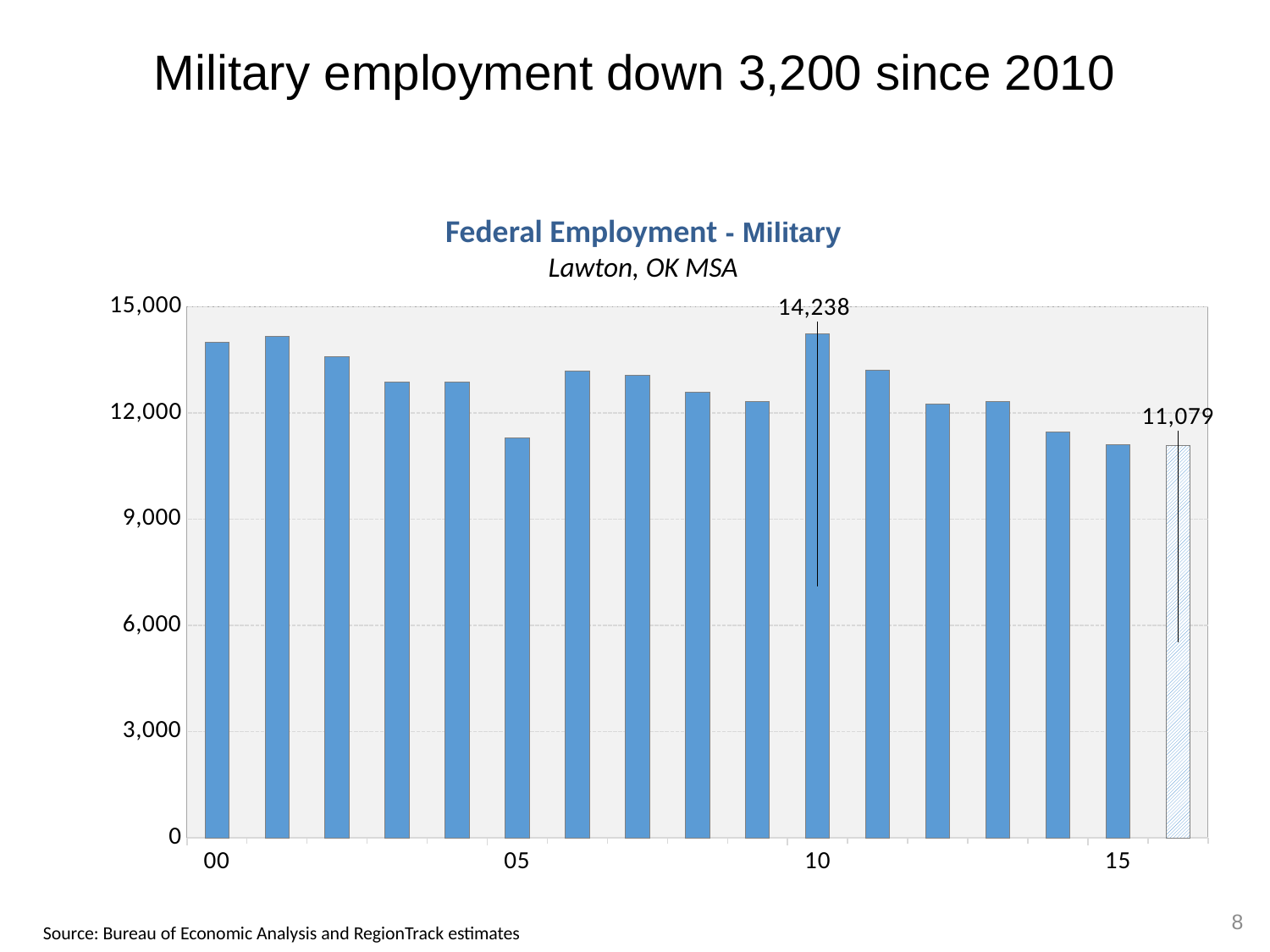
What kind of chart is shown on the slide? Bar chart What is the title of the chart? Federal Employment - Military Is the value for 2014 greater or less than 12,000? less What is the value of the bar for 2016 (the hatched bar) in the Federal Employment - Military chart? 11,079 What is the difference between the labeled 2010 value and the labeled 2016 value? 3,159 How many bars (years) are plotted in the chart? 17 Do the values generally rise or fall from 2010 to 2016? Fall What is the value of the bar for 2010 in the Federal Employment - Military chart? 14,238 Which is larger, the value for 2000 or the value for 2005? 2000 Is the value for 2005 greater or less than 12,000? less Which is larger, the value for 2010 or the value for 2016? 2010 Is the value for 2000 greater or less than 12,000? greater